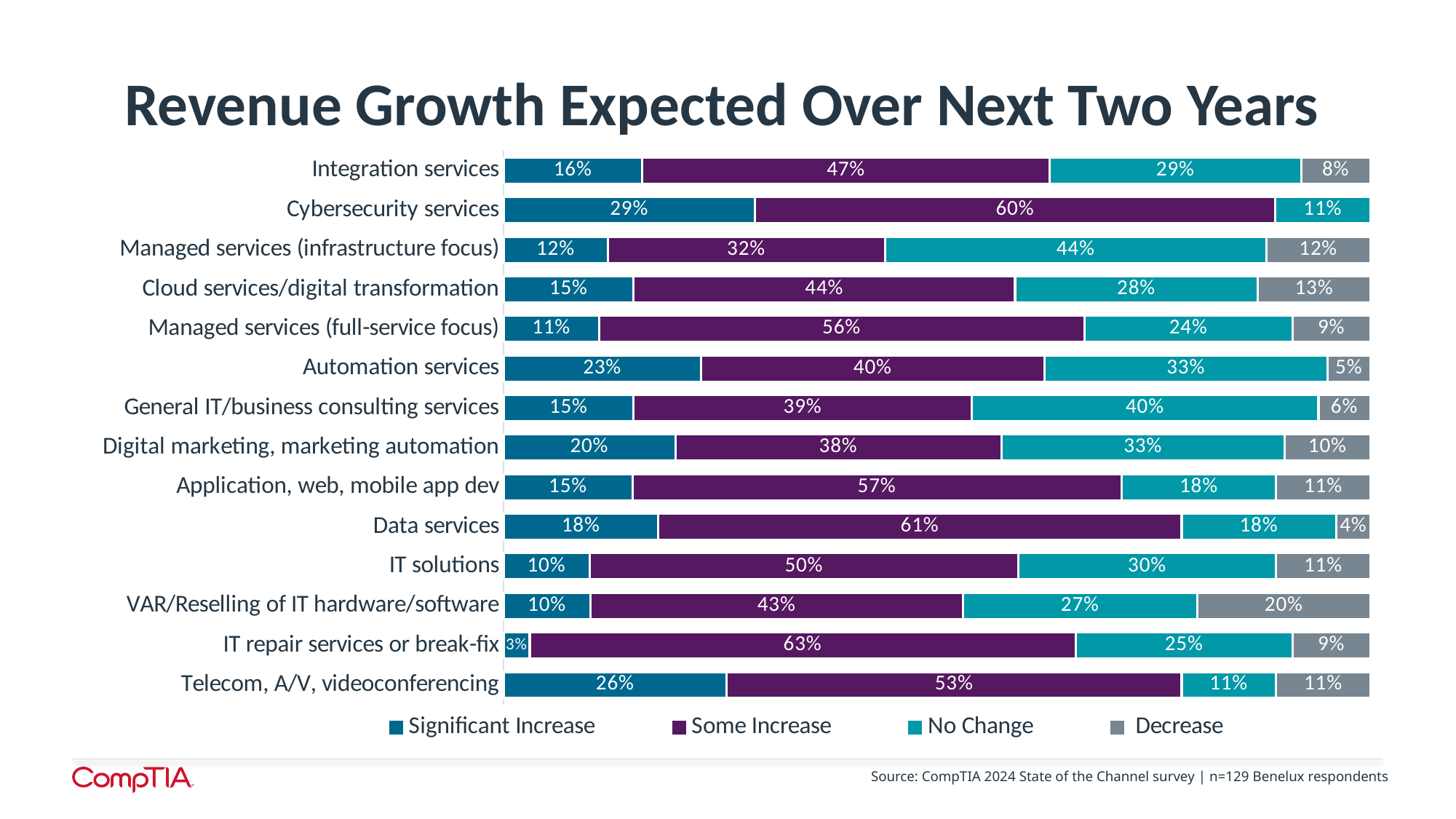
What is the Decrease value for VAR/Reselling of IT hardware/software? 20% Which category has the highest Decrease value? VAR/Reselling of IT hardware/software What is the No Change value for Managed services (infrastructure focus)? 44% What type of chart is shown on the slide? Stacked bar chart What is the difference between the Some Increase values for Data services and Integration services? 14% Which category has the highest Significant Increase value? Cybersecurity services What percentage of respondents expect a Significant Increase for Cybersecurity services? 29% How many categories are shown in the chart? 14 Which is larger: the No Change value for Automation services or for Cloud services/digital transformation? Automation services Which category has the lowest Significant Increase value? IT repair services or break-fix What is the Some Increase value for IT repair services or break-fix? 63% How many series does the legend list? 4